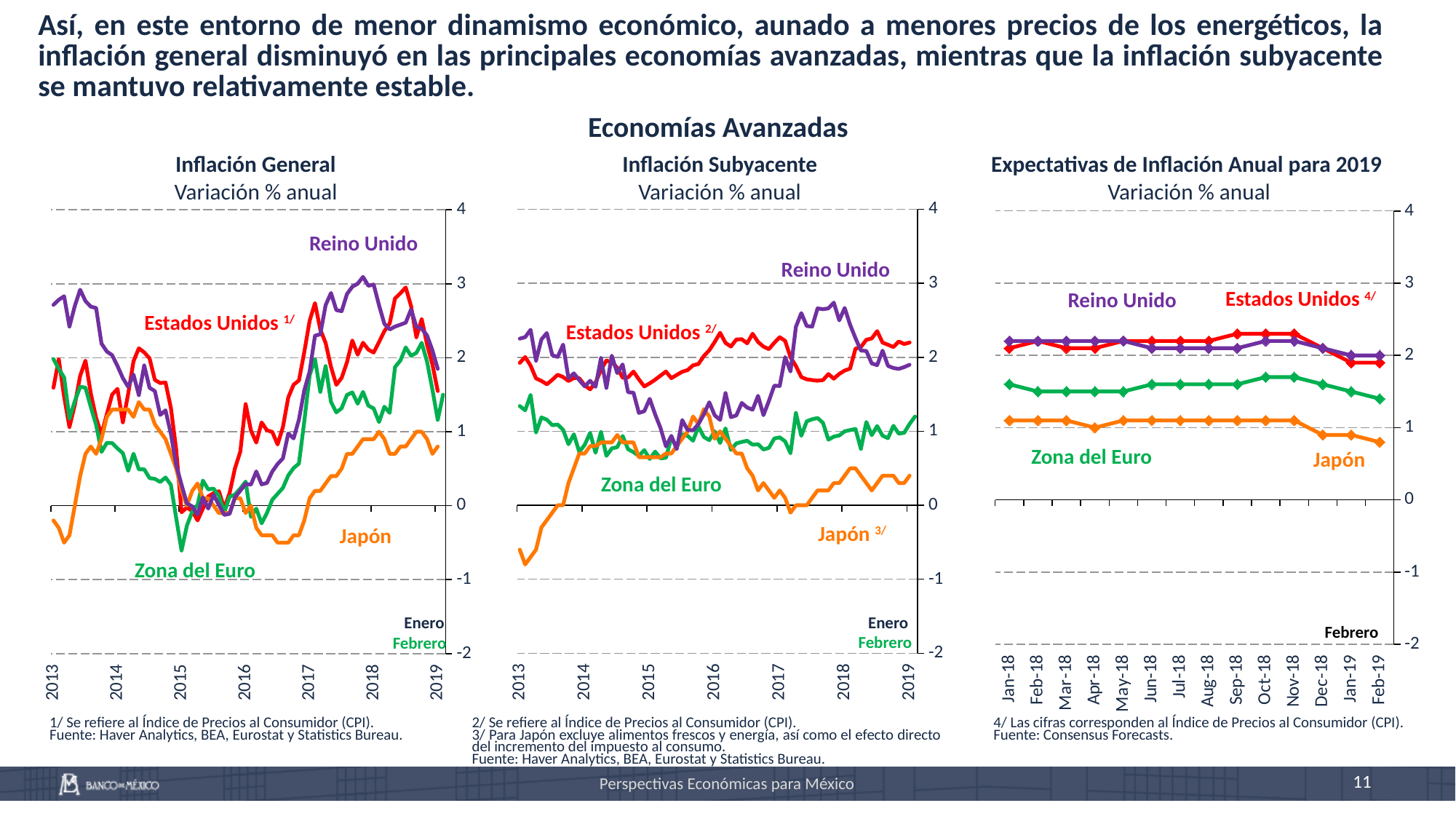
In the 'Expectativas de Inflación Anual para 2019' chart, is the value for Japón in Feb-19 greater or less than 1? less In the 'Inflación Subyacente' chart, is the value for Japón at the start of 2013 greater or less than 0? less In the 'Expectativas de Inflación Anual para 2019' chart, does the Zona del Euro series rise or fall from Nov-18 to Feb-19? fall How many series are labelled in the 'Inflación General' chart? 4 What kind of chart is the 'Inflación General' chart on the left? line chart In the 'Inflación Subyacente' chart, is the peak value for Reino Unido during 2017 greater or less than 2? greater In the 'Expectativas de Inflación Anual para 2019' chart, which series is lowest in Feb-19? Japón How many months are shown on the x axis of the 'Expectativas de Inflación Anual para 2019' chart? 14 What colour is the Japón line in the 'Inflación General' chart? orange In the 'Expectativas de Inflación Anual para 2019' chart, which is larger in Feb-19, Reino Unido or Japón? Reino Unido